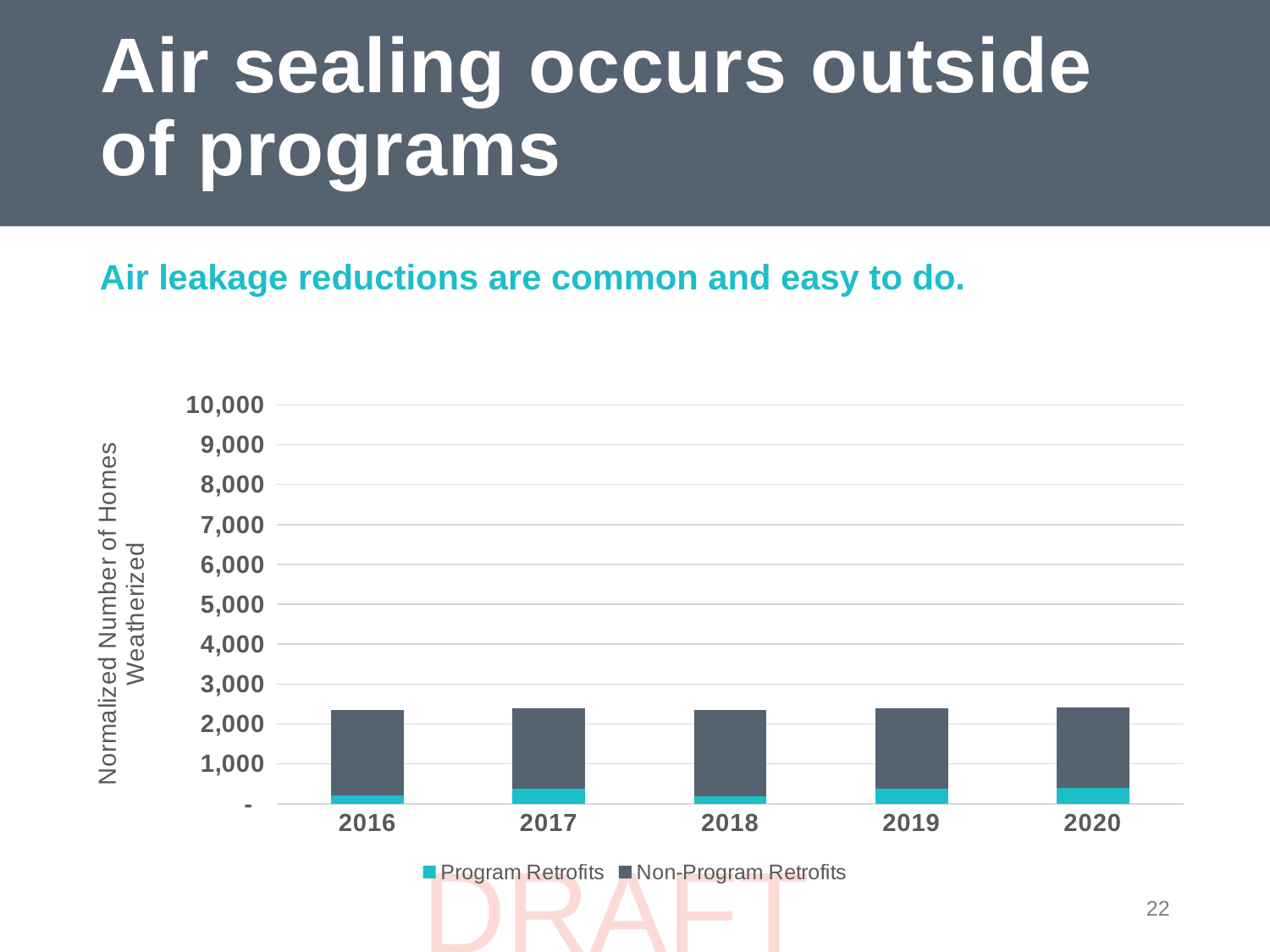
Is the Program Retrofits value for 2017 greater or less than 1,000? less What are the two series named in the chart's legend? Program Retrofits and Non-Program Retrofits Is the total stacked value for 2018 greater or less than 5,000? less How many series does the chart's legend list? 2 What is the label on the chart's vertical axis? Normalized Number of Homes Weatherized In 2016, which series is larger: Program Retrofits or Non-Program Retrofits? Non-Program Retrofits What is the highest value shown on the chart's vertical axis? 10,000 What kind of chart is shown on the slide? stacked bar chart How many years are shown on the x axis of the chart? 5 Is the total stacked value for 2016 greater or less than 3,000? less In 2019, which series is larger: Program Retrofits or Non-Program Retrofits? Non-Program Retrofits